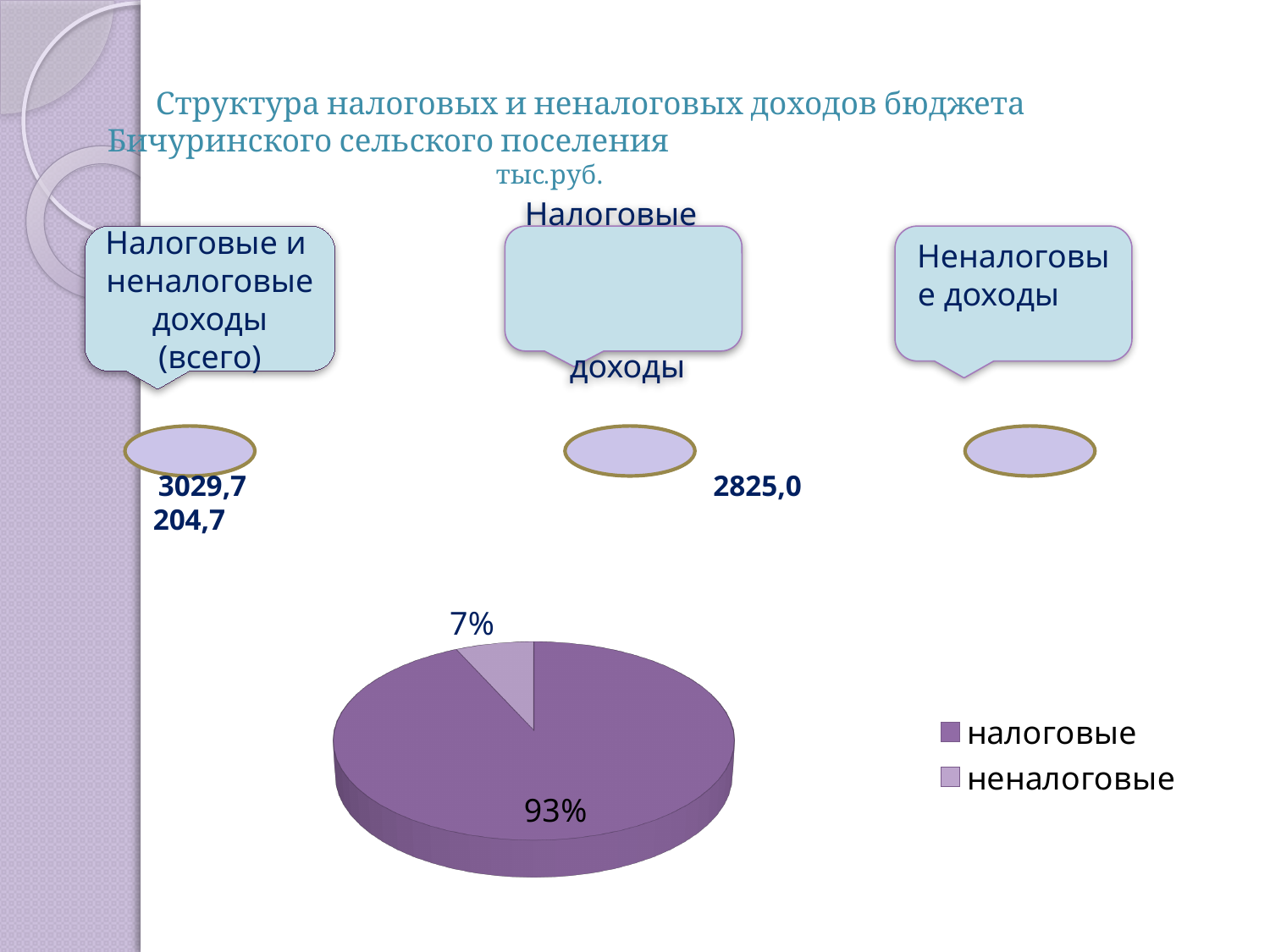
Which legend entry is shown in the lighter purple colour in the pie chart? неналоговые Which slice of the pie chart is the largest? налоговые Is the share of the "налоговые" slice greater or less than 50%? greater What kind of chart is shown on the slide? pie chart What share of the pie does the "неналоговые" slice represent? 7% What share of the pie does the "налоговые" slice represent? 93% How many slices does the pie chart have? 2 Which slice of the pie chart is the smallest? неналоговые What is the difference in percentage points between the "налоговые" and "неналоговые" slices? 86 What are the two entries listed in the pie chart's legend? налоговые, неналоговые How many entries does the legend of the pie chart list? 2 Which is larger in the pie chart, "налоговые" or "неналоговые"? налоговые